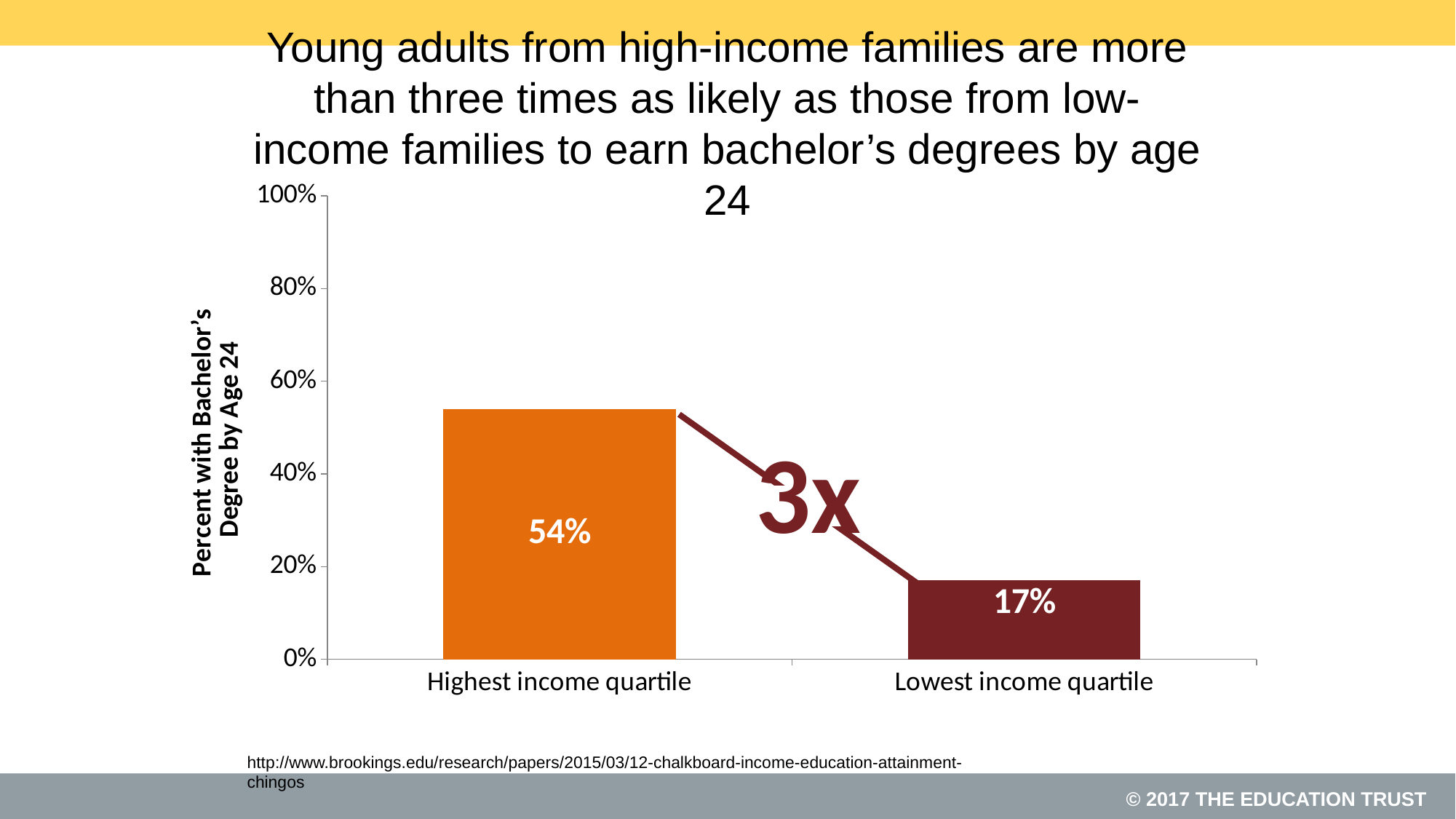
Is the value for Highest income quartile greater or less than 40%? greater What is the value for Highest income quartile? 54% What is the label of the vertical axis? Percent with Bachelor's Degree by Age 24 What kind of chart is shown on the slide? Bar chart What is the difference between the values for Highest income quartile and Lowest income quartile? 37% Is the value for Lowest income quartile greater or less than 20%? less Which is larger, the value for Highest income quartile or Lowest income quartile? Highest income quartile Which category has the highest value? Highest income quartile What multiplier is annotated between the two bars? 3x How many categories are shown on the x axis? 2 Which category has the lowest value? Lowest income quartile What is the value for Lowest income quartile? 17%